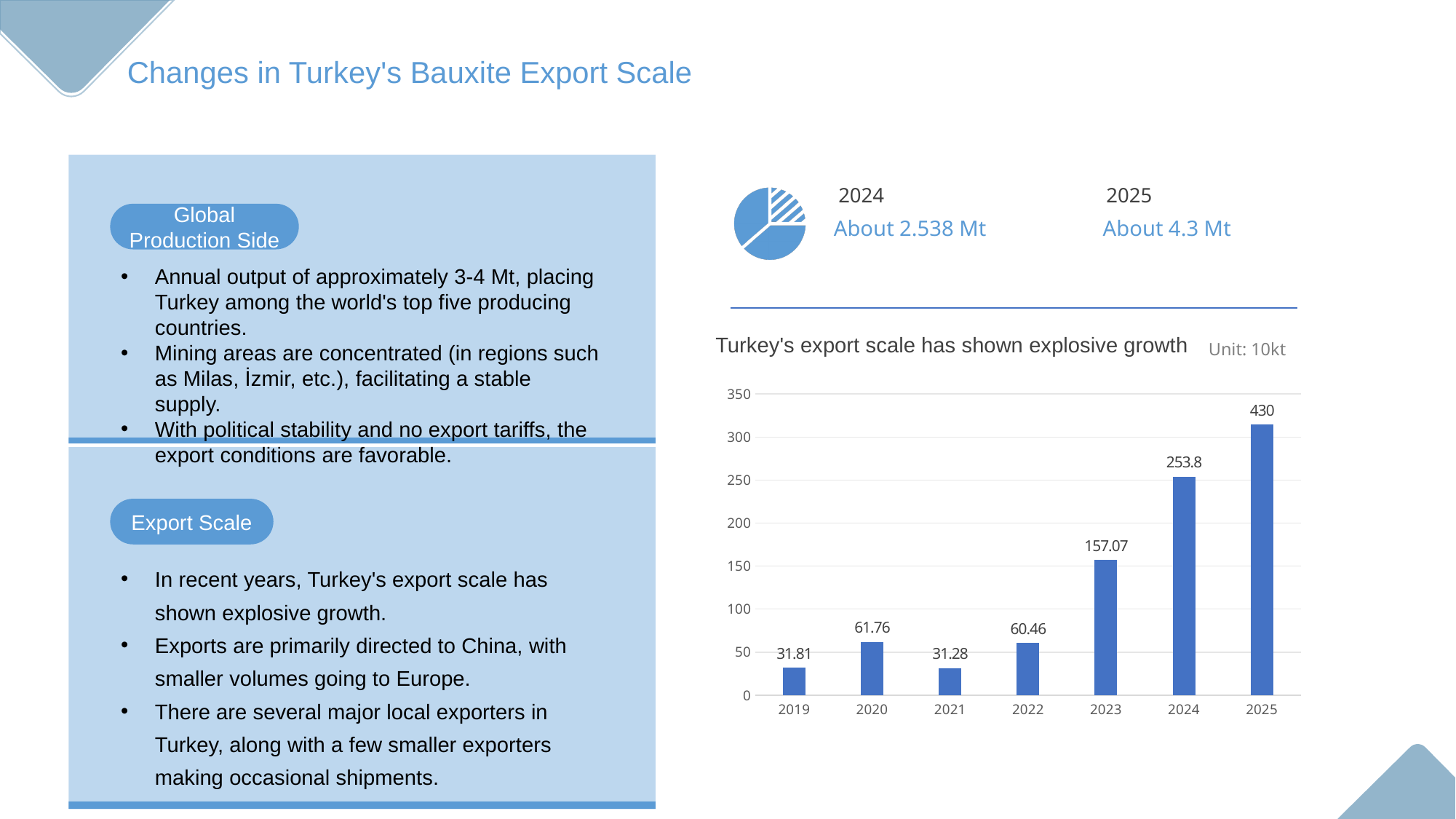
What unit is stated for the values in the bar chart? 10kt What is the value for 2019 in the bar chart? 31.81 What is the value for 2024 in the bar chart? 253.8 What is the value for 2023 in the bar chart? 157.07 What kind of chart is shown on the slide? bar chart What is the value for 2025 in the bar chart? 430 How many years are shown on the x axis of the bar chart? 7 Which is larger in the bar chart, the value for 2020 or the value for 2022? 2020 Which year has the lowest value in the bar chart? 2021 Do the values in the bar chart generally rise or fall from 2021 to 2025? rise What is the difference between the values for 2024 and 2023 in the bar chart? 96.73 Which year has the highest value in the bar chart? 2025